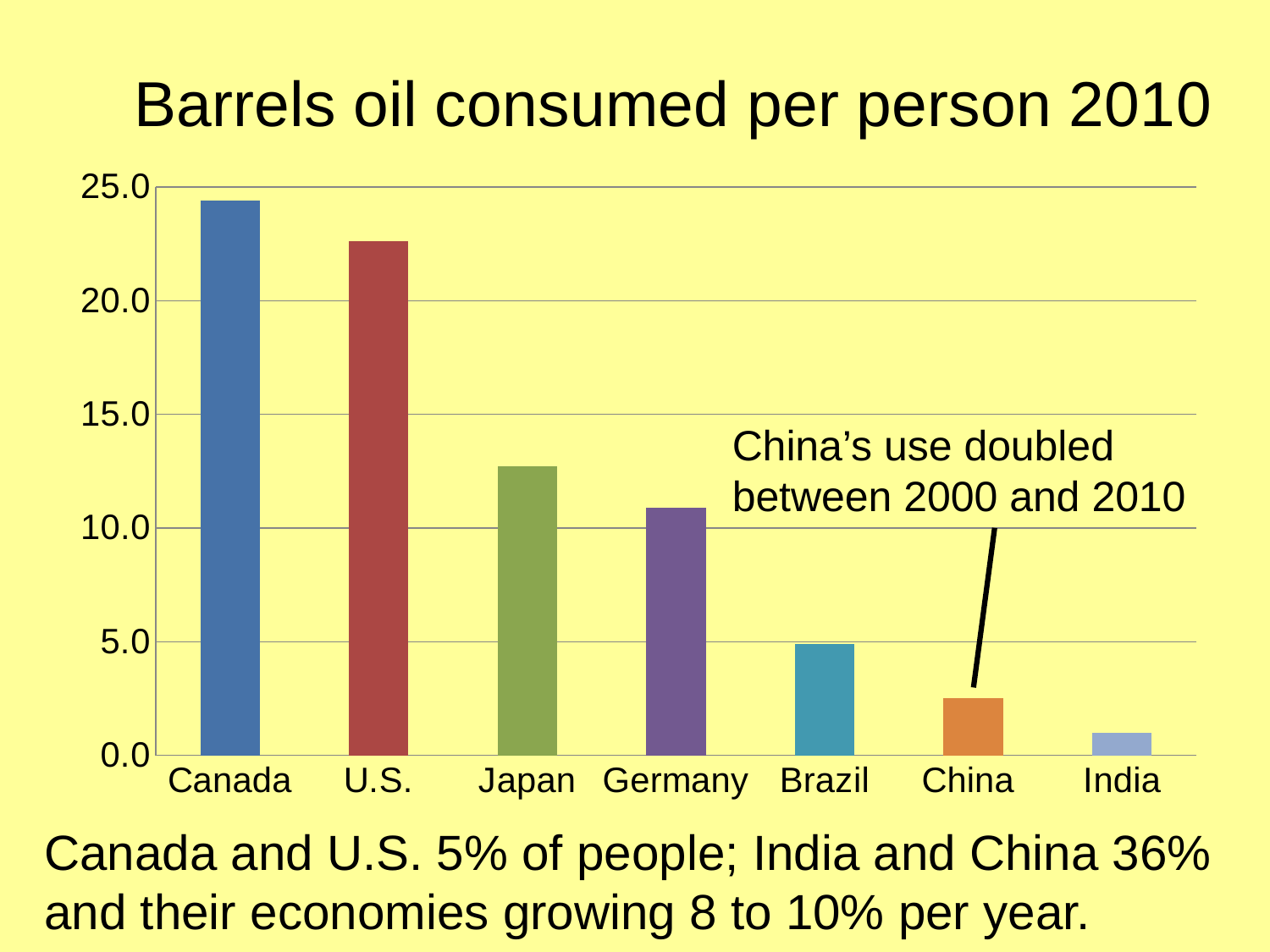
Which country has the lowest barrels of oil consumed per person? India How many countries are shown on the x axis of the chart? 7 Is the value for the U.S. greater or less than 20.0? greater What type of chart is shown on the slide? Bar chart What is the title of the chart? Barrels oil consumed per person 2010 Is the value for Japan greater or less than 15.0? less Which has a higher value, Japan or Germany? Japan Which country has the highest barrels of oil consumed per person? Canada Do the values generally rise or fall moving from left to right along the x axis? Fall Is the value for China greater or less than 5.0? less Which has a higher value, Brazil or China? Brazil According to the annotation on the chart, which country's oil use doubled between 2000 and 2010? China